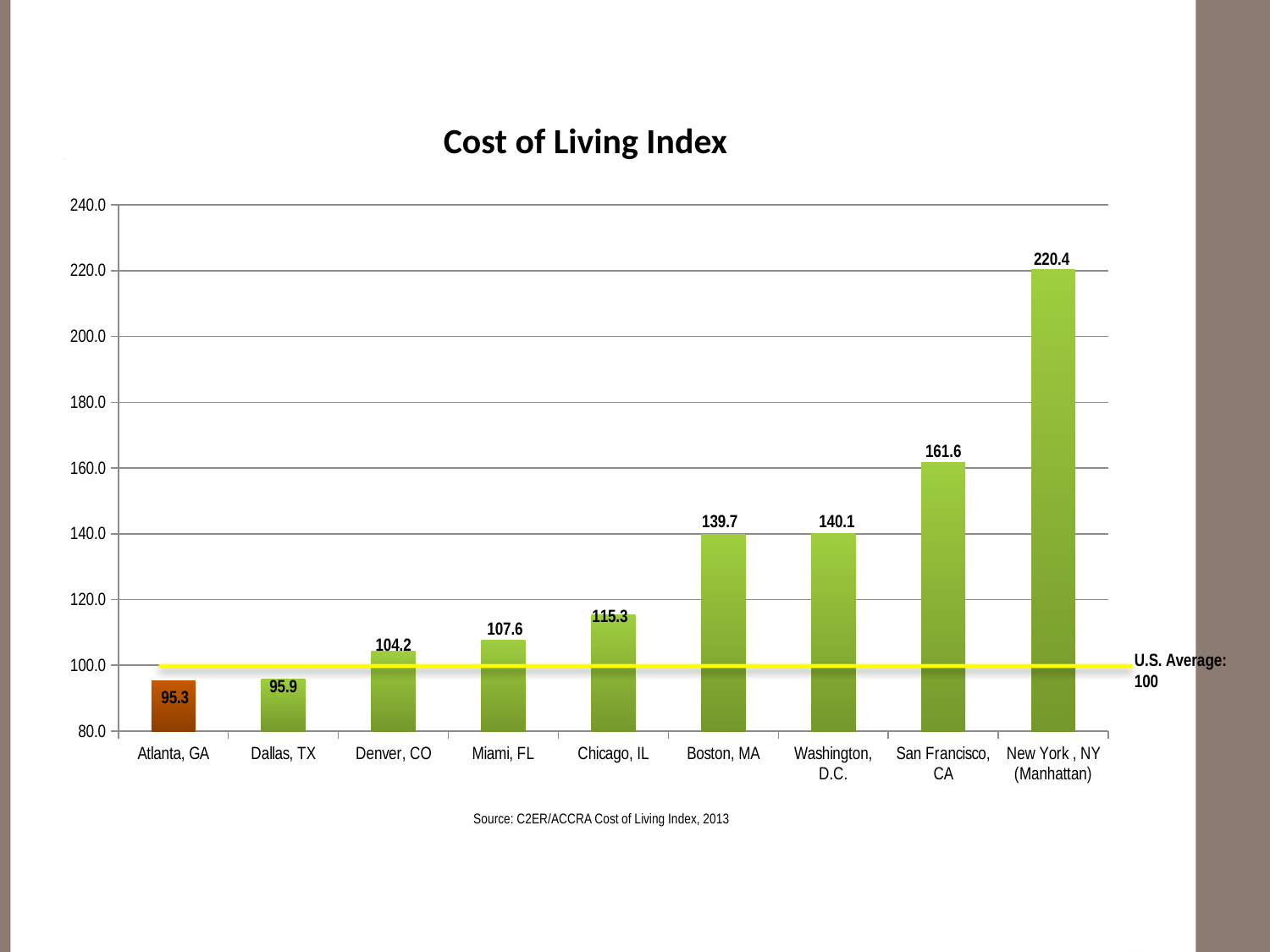
What value does the yellow horizontal line labeled U.S. Average mark? 100 What is the difference between the Cost of Living Index for Miami, FL and Denver, CO? 3.4 What is the Cost of Living Index value for Chicago, IL? 115.3 What is the difference between the Cost of Living Index for New York, NY (Manhattan) and San Francisco, CA? 58.8 What kind of chart is used to show the Cost of Living Index? bar chart How many cities are shown in the Cost of Living Index chart? 9 Which city has the lowest Cost of Living Index? Atlanta, GA Which city has the highest Cost of Living Index? New York, NY (Manhattan) Is the Cost of Living Index for Dallas, TX greater or less than 100? less What is the Cost of Living Index value for San Francisco, CA? 161.6 What is the Cost of Living Index value for Atlanta, GA? 95.3 Which has a higher Cost of Living Index, Boston, MA or San Francisco, CA? San Francisco, CA